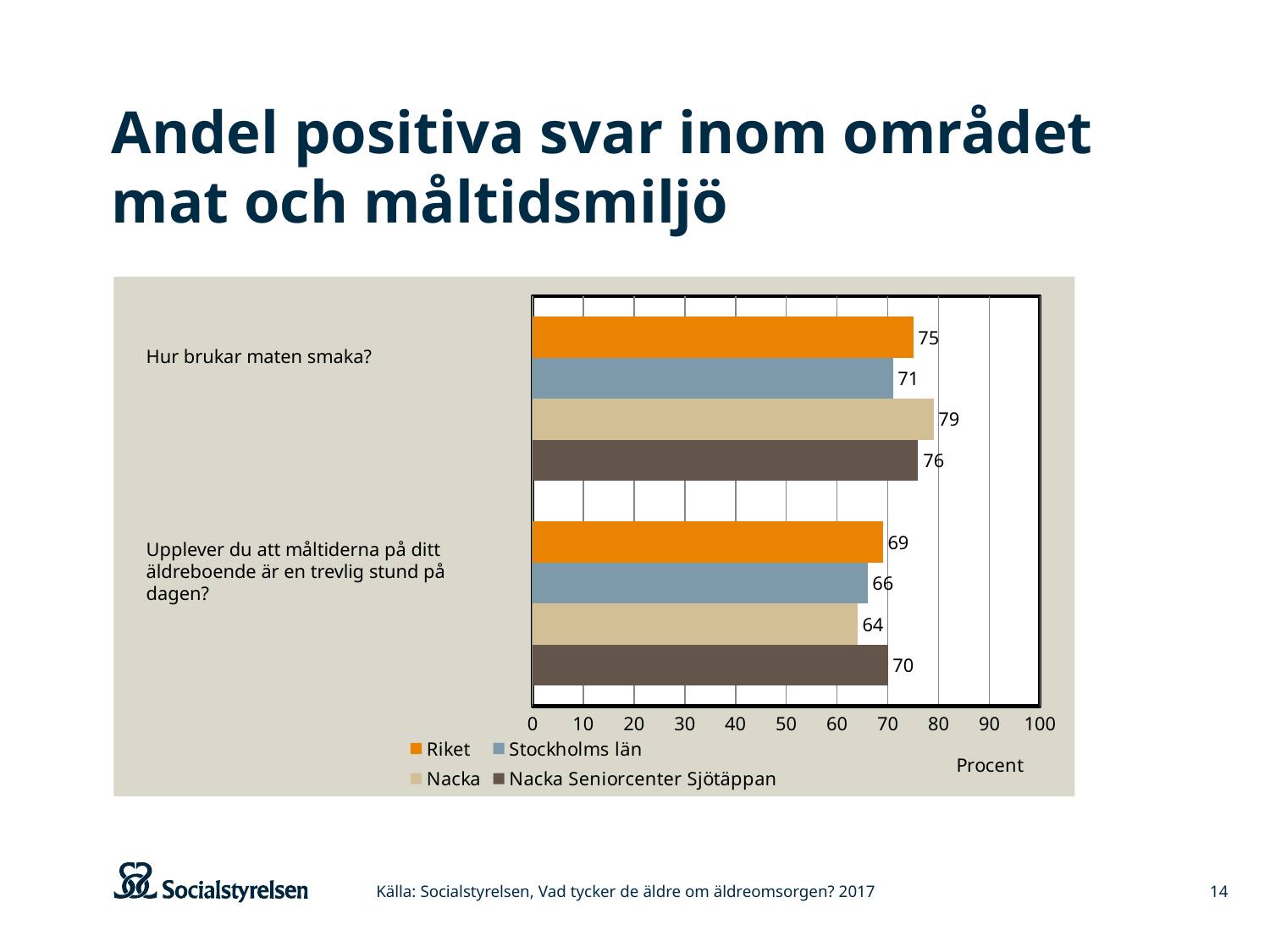
How many questions (categories) are shown on the chart? 2 What is the value for Riket for the question "Hur brukar maten smaka?"? 75 Which series has the highest value for the question "Hur brukar maten smaka?"? Nacka What is the value for Nacka Seniorcenter Sjötäppan for the question "Upplever du att måltiderna på ditt äldreboende är en trevlig stund på dagen?"? 70 What is the value for Stockholms län for the question "Upplever du att måltiderna på ditt äldreboende är en trevlig stund på dagen?"? 66 Which is larger for the question "Upplever du att måltiderna på ditt äldreboende är en trevlig stund på dagen?": Riket or Nacka? Riket What is the value for Nacka for the question "Hur brukar maten smaka?"? 79 What kind of chart is shown on the slide? Bar chart Which series has the lowest value for the question "Upplever du att måltiderna på ditt äldreboende är en trevlig stund på dagen?"? Nacka What is the difference between the Nacka and Stockholms län values for the question "Hur brukar maten smaka?"? 8 What is the label of the horizontal axis? Procent How many series does the legend list? 4